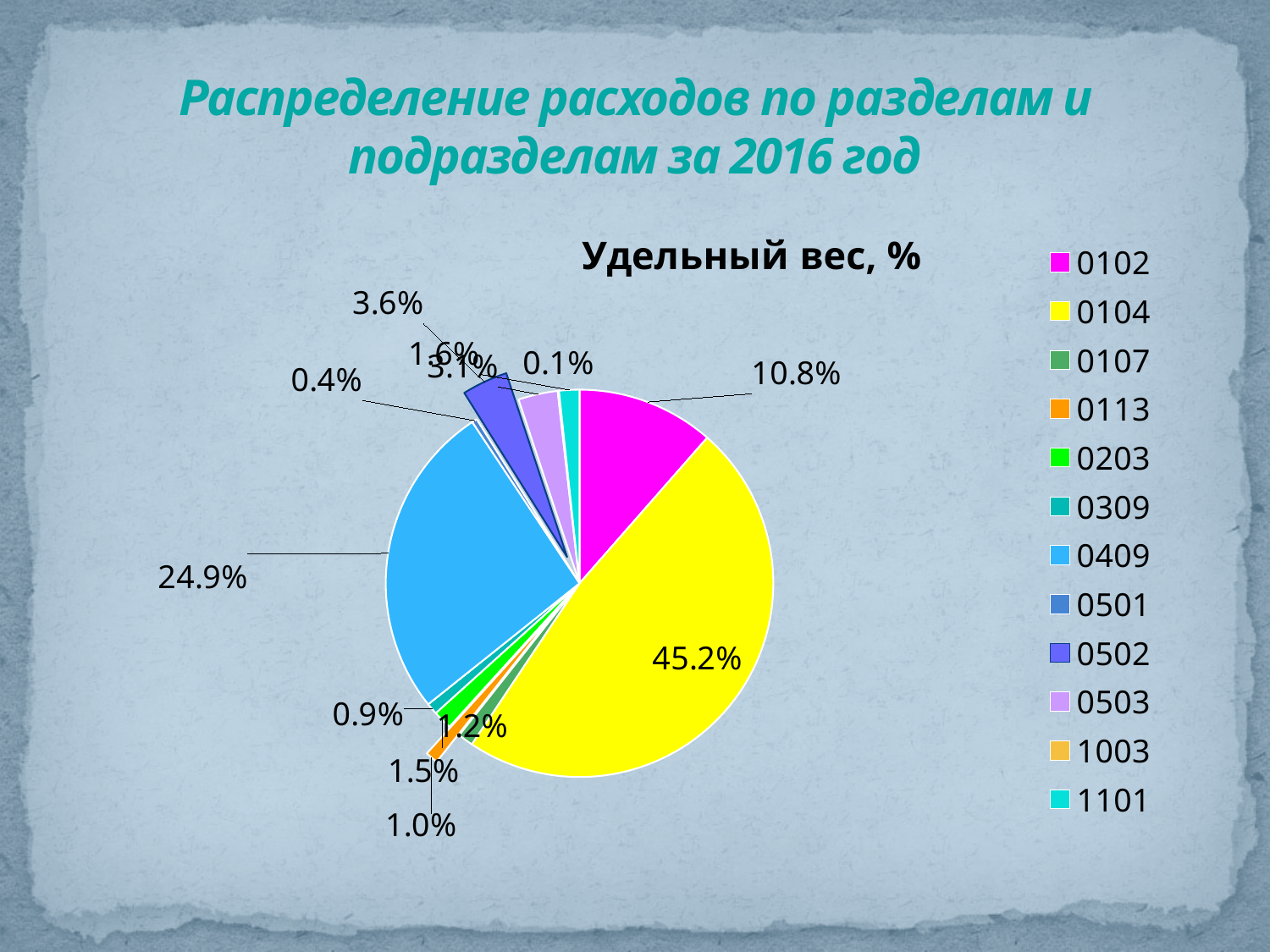
What is the title of the chart? Удельный вес, % What colour is the slice for category 0104? Yellow Which is larger, the slice for 0104 or the slice for 0409? 0104 What is the difference between the values for 0104 and 0409? 20.3 percentage points How many categories does the legend of the pie chart list? 12 What is the value shown for category 0104 in the pie chart? 45.2% Which is larger, the slice for 0409 or the slice for 0102? 0409 What is the value shown for category 0409 in the pie chart? 24.9% Which category has the largest slice in the pie chart? 0104 What is the difference between the values for 0409 and 0102? 14.1 percentage points What is the value shown for category 0102 in the pie chart? 10.8% What kind of chart is shown on the slide? Pie chart